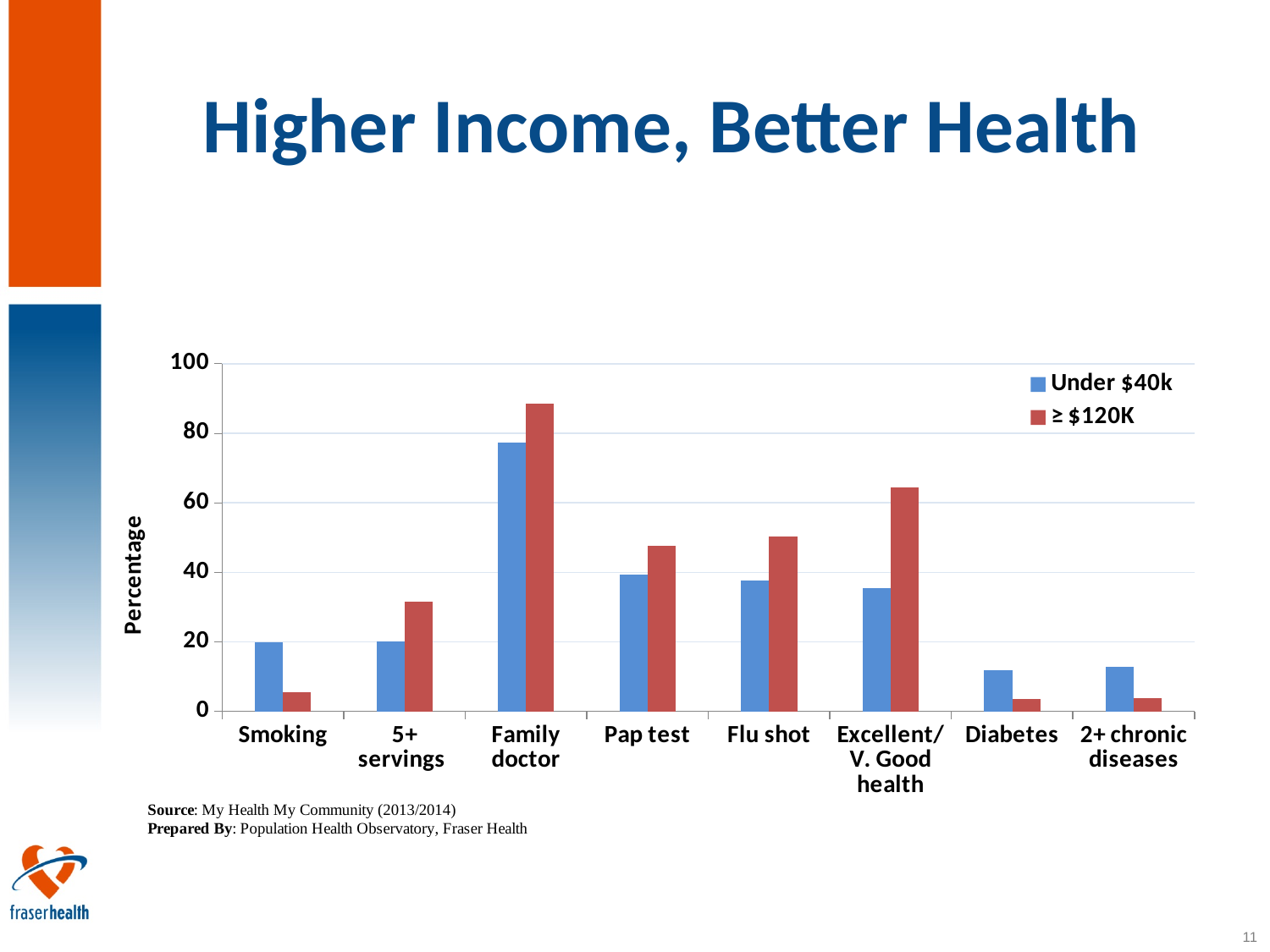
For Excellent/V. Good health, which group has the larger value, Under $40k or ≥ $120K? ≥ $120K What is the label on the chart's vertical axis? Percentage What kind of chart is shown on the slide? bar chart Is the ≥ $120K value for Family doctor greater or less than 80? greater How many series does the chart's legend list? 2 What are the two series named in the chart's legend? Under $40k and ≥ $120K For Smoking, which group has the larger value, Under $40k or ≥ $120K? Under $40k For which category is the ≥ $120K bar the highest? Family doctor For which category is the Under $40k bar the highest? Family doctor How many categories are shown along the x axis of the chart? 8 Is the ≥ $120K value for Smoking greater or less than 20? less Is the ≥ $120K value for Excellent/V. Good health greater or less than 60? greater